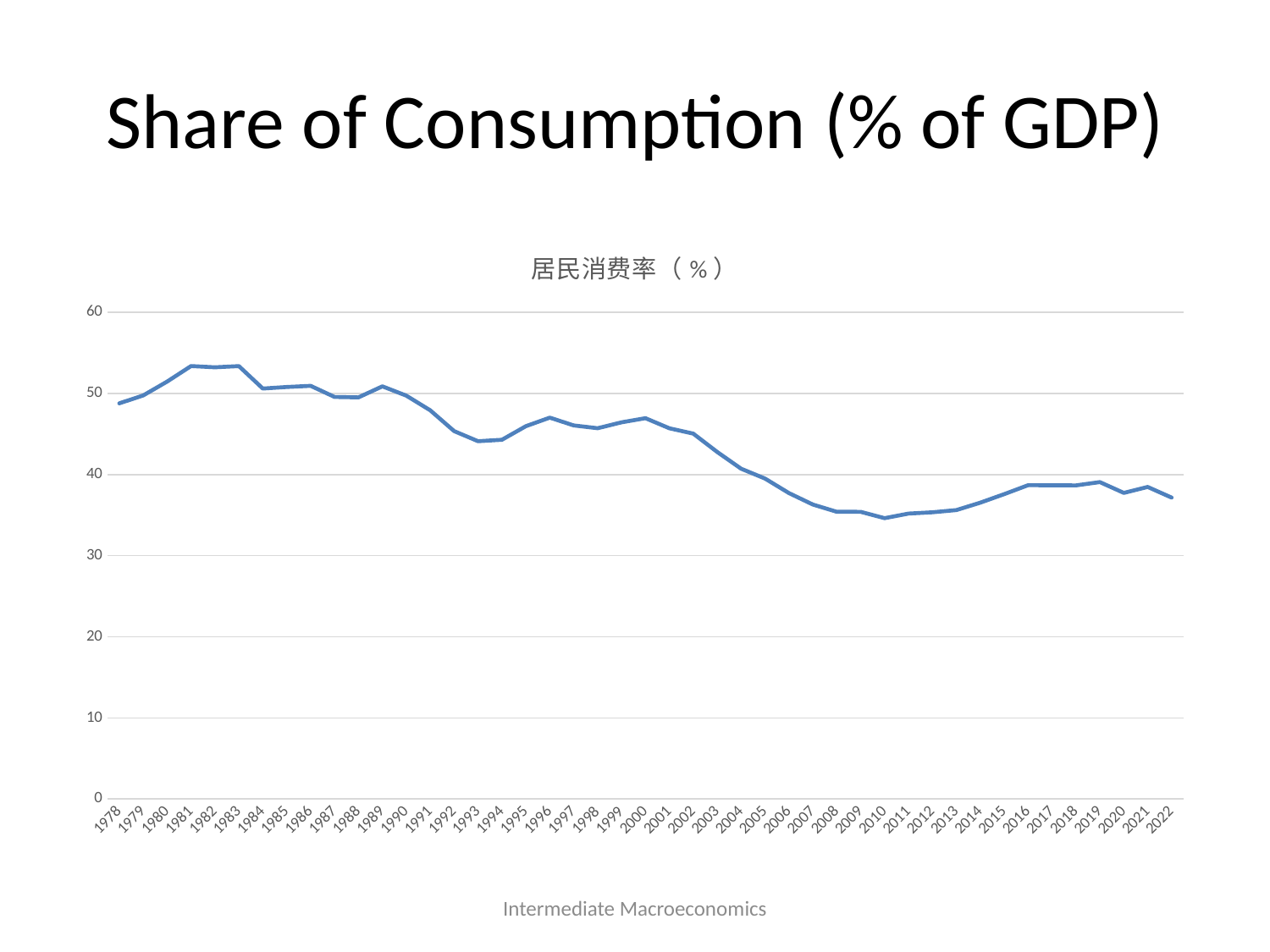
Overall, does the consumption share rise or fall from 1978 to 2022? fall Is the value for 1981 greater or less than 50? greater Is the value for 2010 greater or less than 40? less Which year has the larger value, 1978 or 2022? 1978 What is the title of the chart? 居民消费率（%） Is the value for 2022 greater or less than 40? less What is the first year shown on the x axis? 1978 How many years are plotted along the x axis of the chart? 45 What kind of chart is shown on the slide? line chart